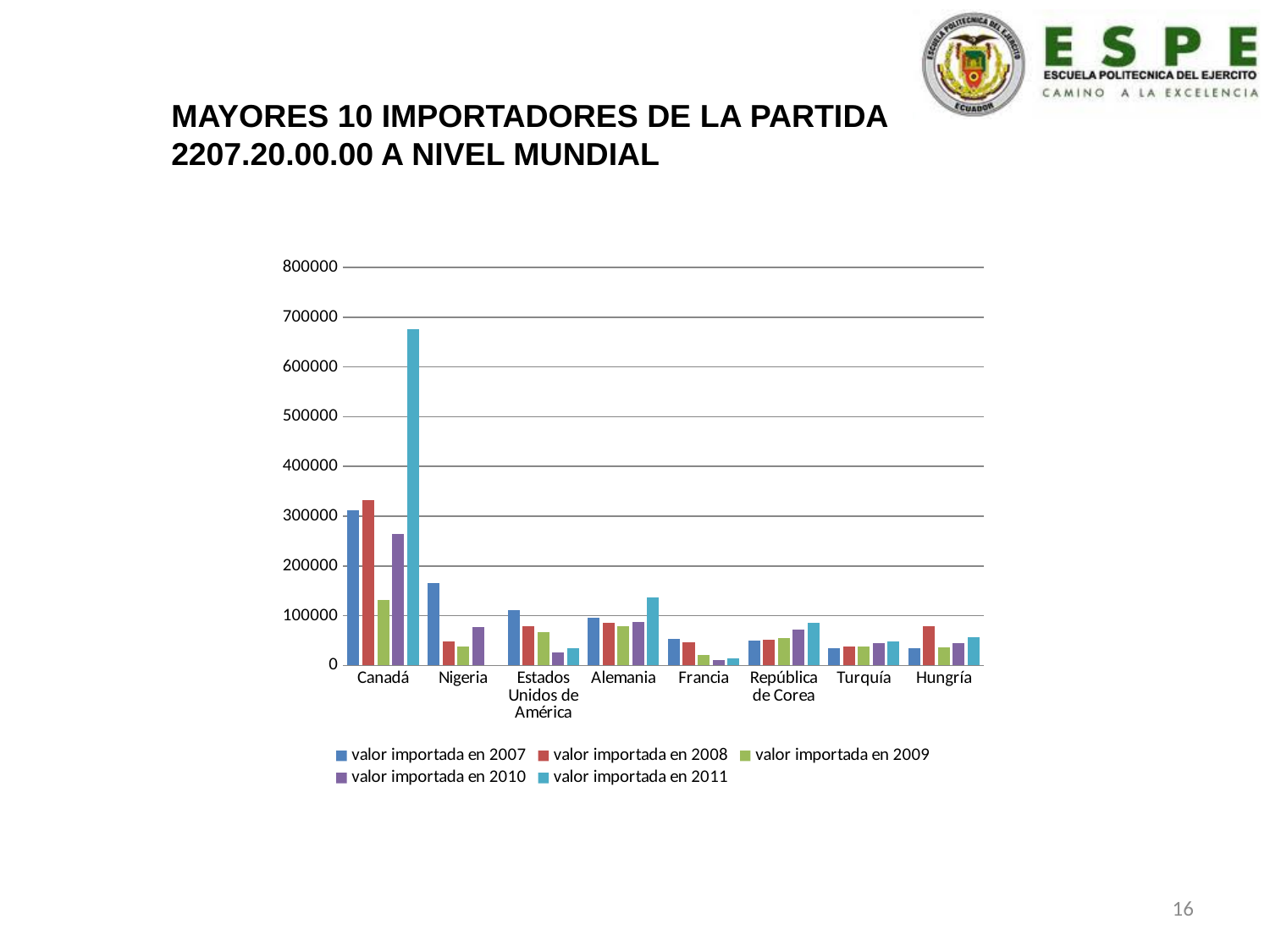
Is the value for Alemania in 'valor importada en 2011' greater or less than 100000? greater Is the value for Francia in 'valor importada en 2011' greater or less than 100000? less Which colour represents 'valor importada en 2011' in the chart? light blue Is the value for Canadá in 'valor importada en 2011' greater or less than 600000? greater Which series has the tallest bar for Canadá? valor importada en 2011 For Canadá, which is larger: 'valor importada en 2008' or 'valor importada en 2009'? valor importada en 2008 What kind of chart is shown on the slide? bar chart How many countries are shown on the x axis of the chart? 8 How many series does the chart's legend list? 5 Which country has the tallest bar in the chart? Canadá Which is larger: the 'valor importada en 2007' bar for Nigeria or for Alemania? Nigeria